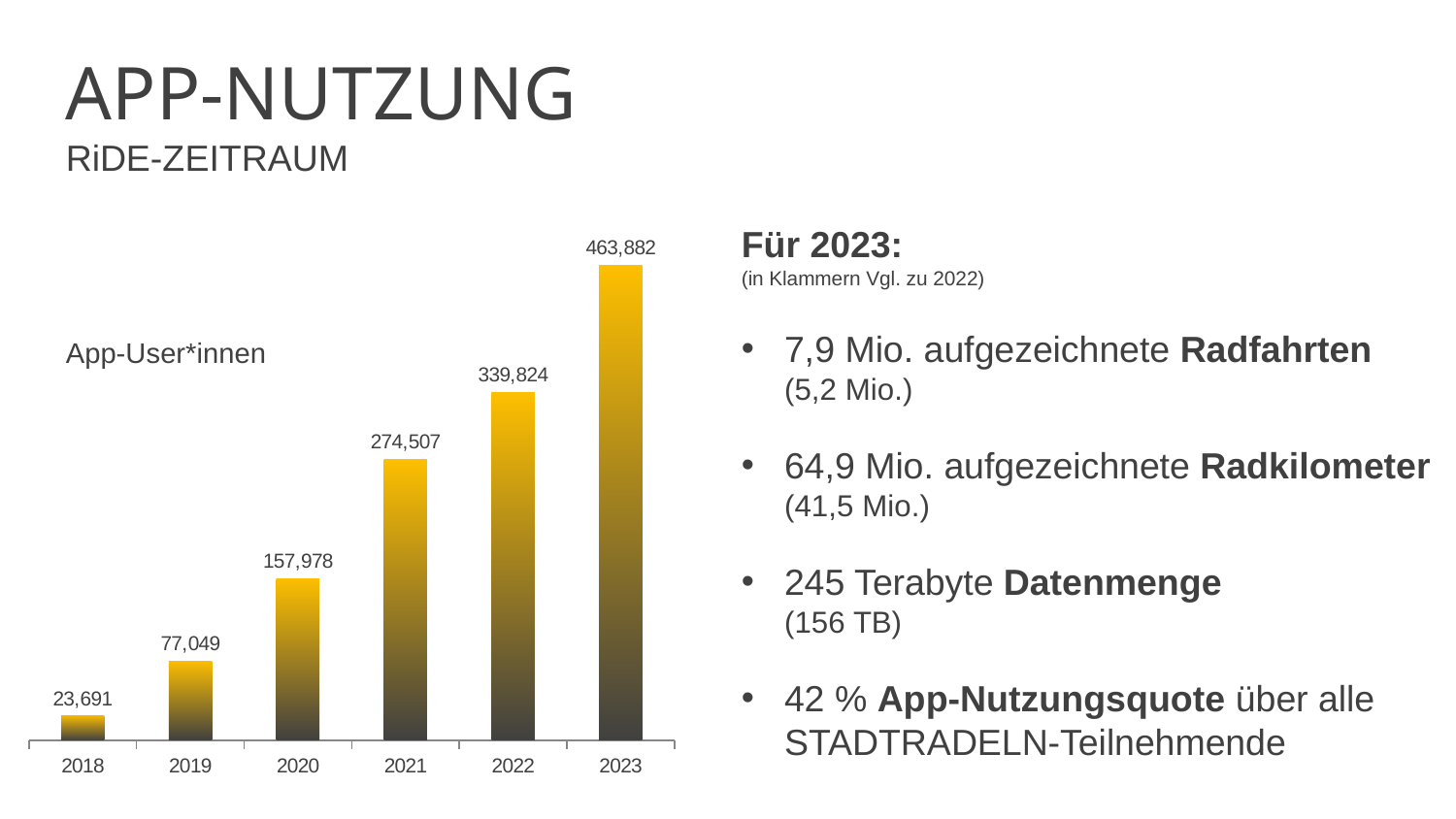
Which year has the lowest value in the App-User*innen chart? 2018 What is the value for 2021 in the App-User*innen chart? 274,507 What kind of chart is used to show App-User*innen? bar chart What is the difference between the values for 2023 and 2022 in the App-User*innen chart? 124,058 Do the values in the App-User*innen chart rise or fall from 2018 to 2023? rise What is the value for 2018 in the App-User*innen chart? 23,691 Which year has the highest value in the App-User*innen chart? 2023 What is the value for 2023 in the App-User*innen chart? 463,882 What is the value for 2020 in the App-User*innen chart? 157,978 How many years are shown on the x axis of the App-User*innen chart? 6 What is the difference between the values for 2019 and 2018 in the App-User*innen chart? 53,358 Which is larger in the App-User*innen chart, the value for 2020 or the value for 2021? 2021